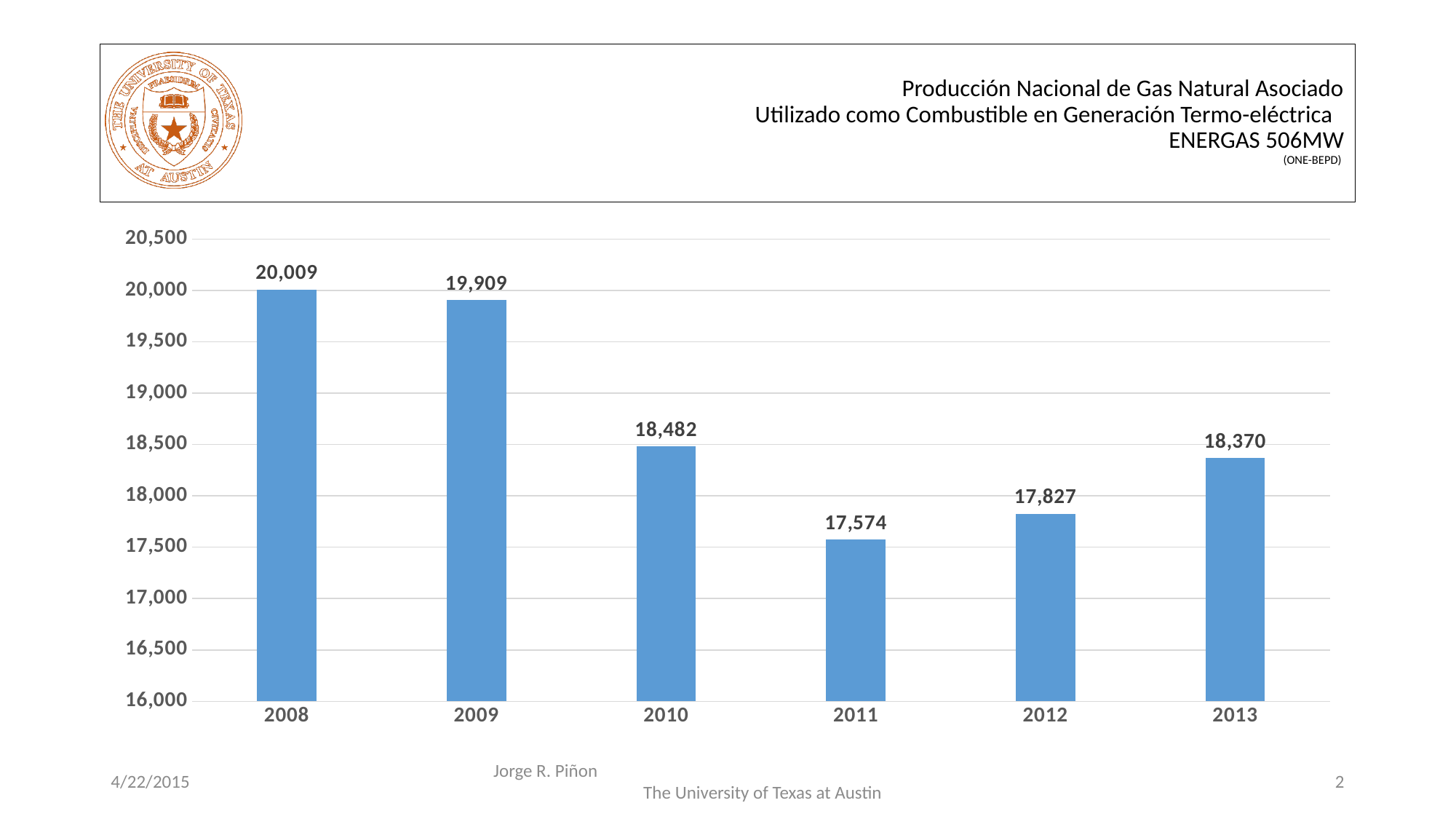
How many years are shown on the x axis? 6 Which is larger, the value for 2010 or the value for 2013? 2010 What is the value for 2011? 17,574 What is the value for 2008? 20,009 What is the difference between the values for 2008 and 2009? 100 Which year has the highest value? 2008 What is the value for 2013? 18,370 What is the difference between the values for 2010 and 2011? 908 What kind of chart is shown on the slide? bar chart Which year has the lowest value? 2011 Is the value for 2012 greater or less than 18,000? less Do the values rise or fall from 2008 to 2011? fall